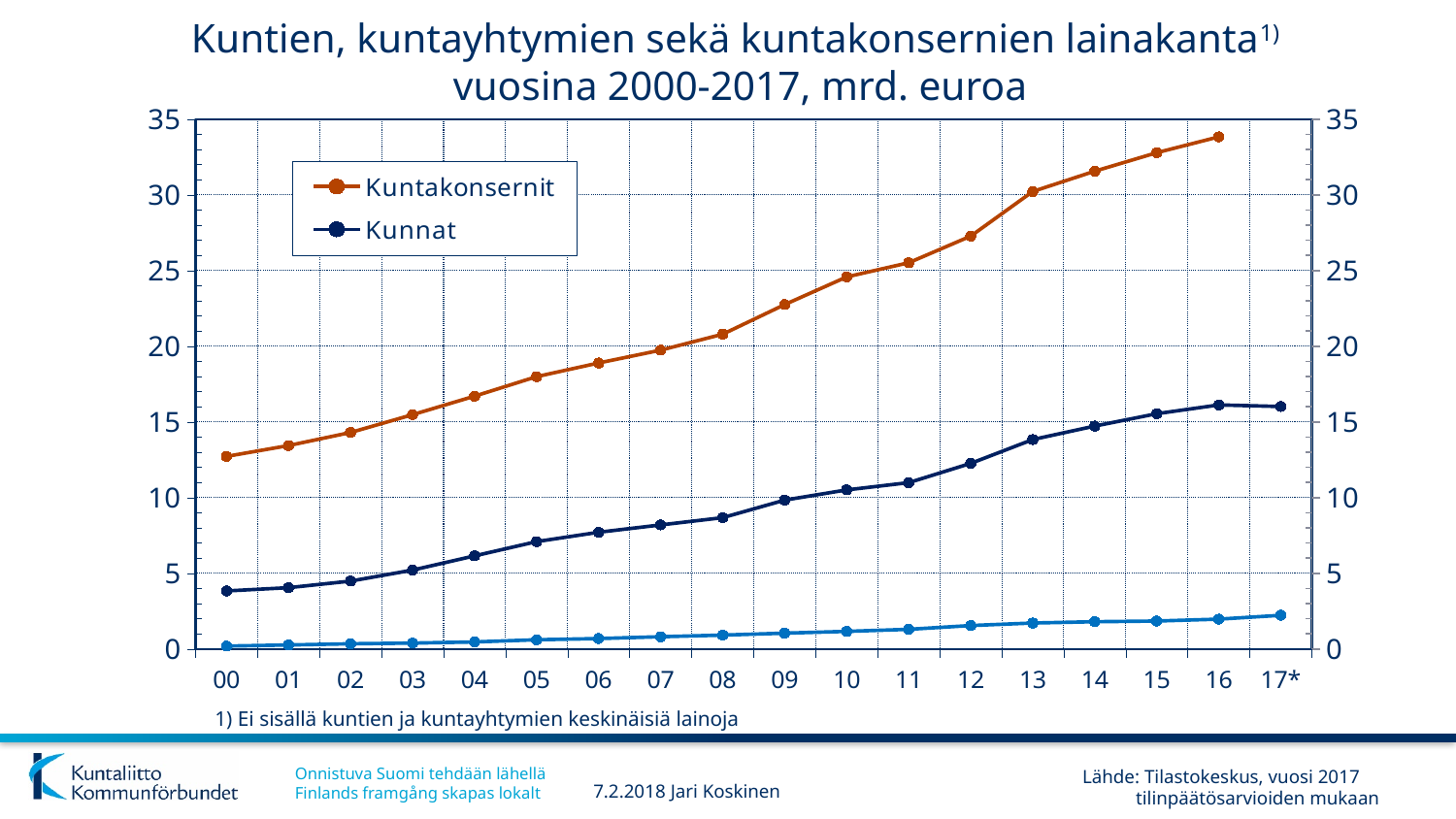
How many years are shown along the x axis of the chart? 18 In which year is the Kuntakonsernit series at its highest? 16 In 10, which series has the larger value, Kuntakonsernit or Kunnat? Kuntakonsernit Is the value for Kuntakonsernit in 00 greater or less than 10? greater In which year is the Kunnat series at its lowest? 00 What unit is stated in the chart title for the values? mrd. euroa Is the value for Kunnat in 00 greater or less than 5? less What kind of chart is shown on the slide? line chart How many series does the chart's legend list? 2 Is the value for Kunnat in 13 greater or less than 15? less Does the Kuntakonsernit series rise or fall from 00 to 17*? rise